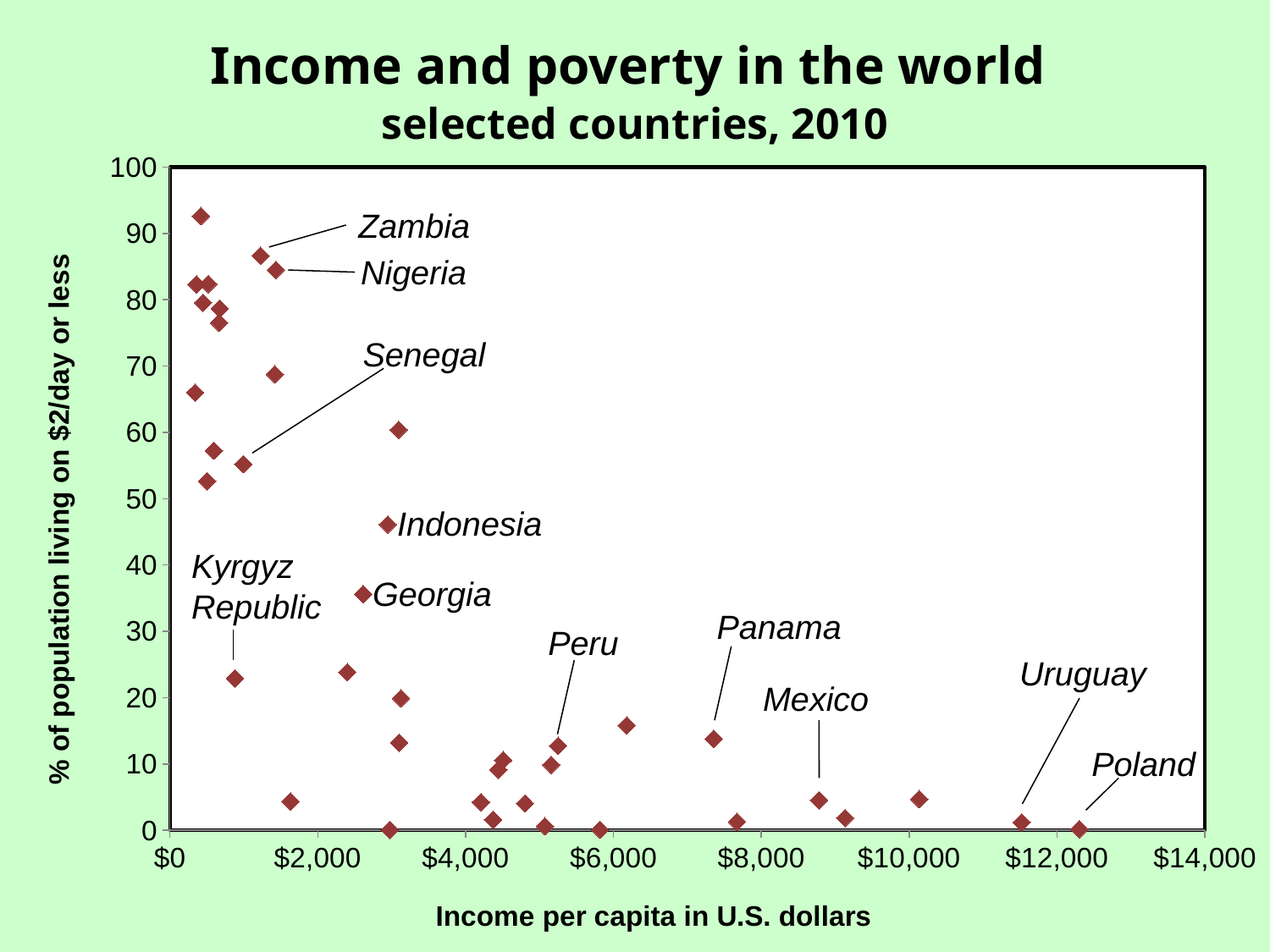
Which country has a higher income per capita, Mexico or Panama? Mexico What does the x axis of the chart measure? Income per capita in U.S. dollars Is the percentage of population living on $2/day or less for Zambia greater or less than 80? greater Is the income per capita for Poland greater or less than $10,000? greater What kind of chart is shown on the slide? Scatter chart Is the percentage of population living on $2/day or less for Indonesia greater or less than 50? less As income per capita increases along the x axis, does the percentage of population living on $2/day or less generally rise or fall? fall What is the title of the chart? Income and poverty in the world, selected countries, 2010 Which country has a higher percentage of population living on $2/day or less, Zambia or Senegal? Zambia